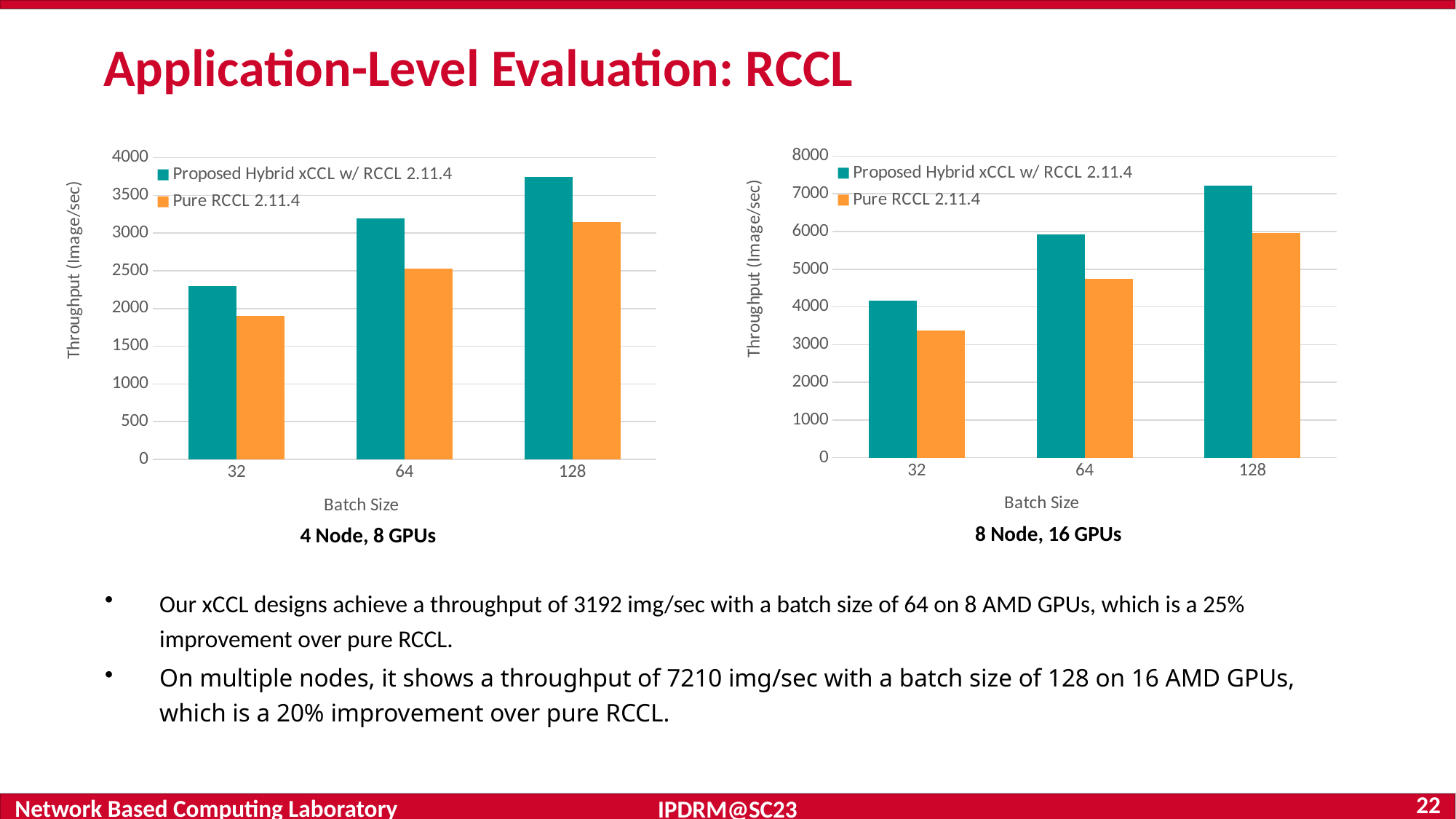
In the '4 Node, 8 GPUs' chart, is the Proposed Hybrid xCCL w/ RCCL 2.11.4 value at batch size 128 greater or less than 3500? greater In the '4 Node, 8 GPUs' chart, does the throughput for Pure RCCL 2.11.4 rise or fall as batch size increases? rise In the '4 Node, 8 GPUs' chart, which batch size has the highest throughput for Proposed Hybrid xCCL w/ RCCL 2.11.4? 128 In the '8 Node, 16 GPUs' chart, is the Pure RCCL 2.11.4 value at batch size 32 greater or less than 4000? less What is the y-axis label of the '8 Node, 16 GPUs' chart? Throughput (Image/sec) In the '8 Node, 16 GPUs' chart, which batch size has the lowest throughput for Pure RCCL 2.11.4? 32 What type of chart is the '4 Node, 8 GPUs' chart? bar chart In the '8 Node, 16 GPUs' chart, is the Proposed Hybrid xCCL w/ RCCL 2.11.4 value at batch size 128 greater or less than 7000? greater In the '8 Node, 16 GPUs' chart, which series has the larger value at batch size 64? Proposed Hybrid xCCL w/ RCCL 2.11.4 How many series does the legend of the '8 Node, 16 GPUs' chart list? 2 How many batch sizes are shown on the x axis of the '4 Node, 8 GPUs' chart? 3